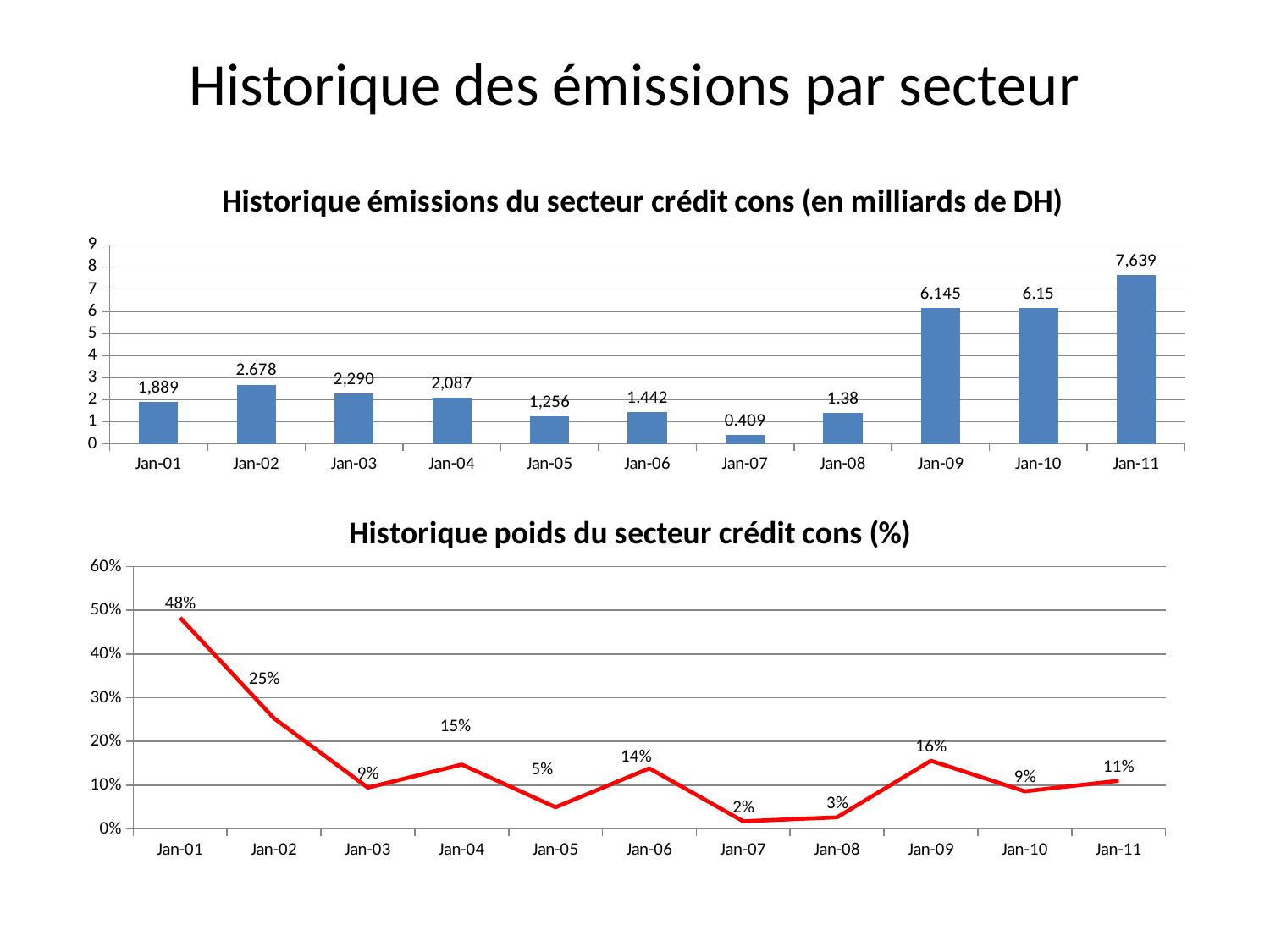
In the bottom chart (Historique poids du secteur crédit cons), what is the difference between the values for Jan-01 and Jan-02? 23% In the top chart (Historique émissions du secteur crédit cons), which year has the highest value? Jan-11 In the top chart (Historique émissions du secteur crédit cons), how many bars are plotted? 11 In the bottom chart (Historique poids du secteur crédit cons), which year has the highest value? Jan-01 What kind of chart is the bottom chart (Historique poids du secteur crédit cons)? Line chart What kind of chart is the top chart (Historique émissions du secteur crédit cons)? Bar chart In the top chart (Historique émissions du secteur crédit cons), which year has the lowest value? Jan-07 In the bottom chart (Historique poids du secteur crédit cons), which year has the lowest value? Jan-07 In the top chart (Historique émissions du secteur crédit cons), which is larger, the value for Jan-02 or the value for Jan-05? Jan-02 In the top chart (Historique émissions du secteur crédit cons), what is the value for Jan-11? 7,639 In the top chart (Historique émissions du secteur crédit cons), what is the value for Jan-07? 0.409 In the bottom chart (Historique poids du secteur crédit cons), what is the value for Jan-09? 16%